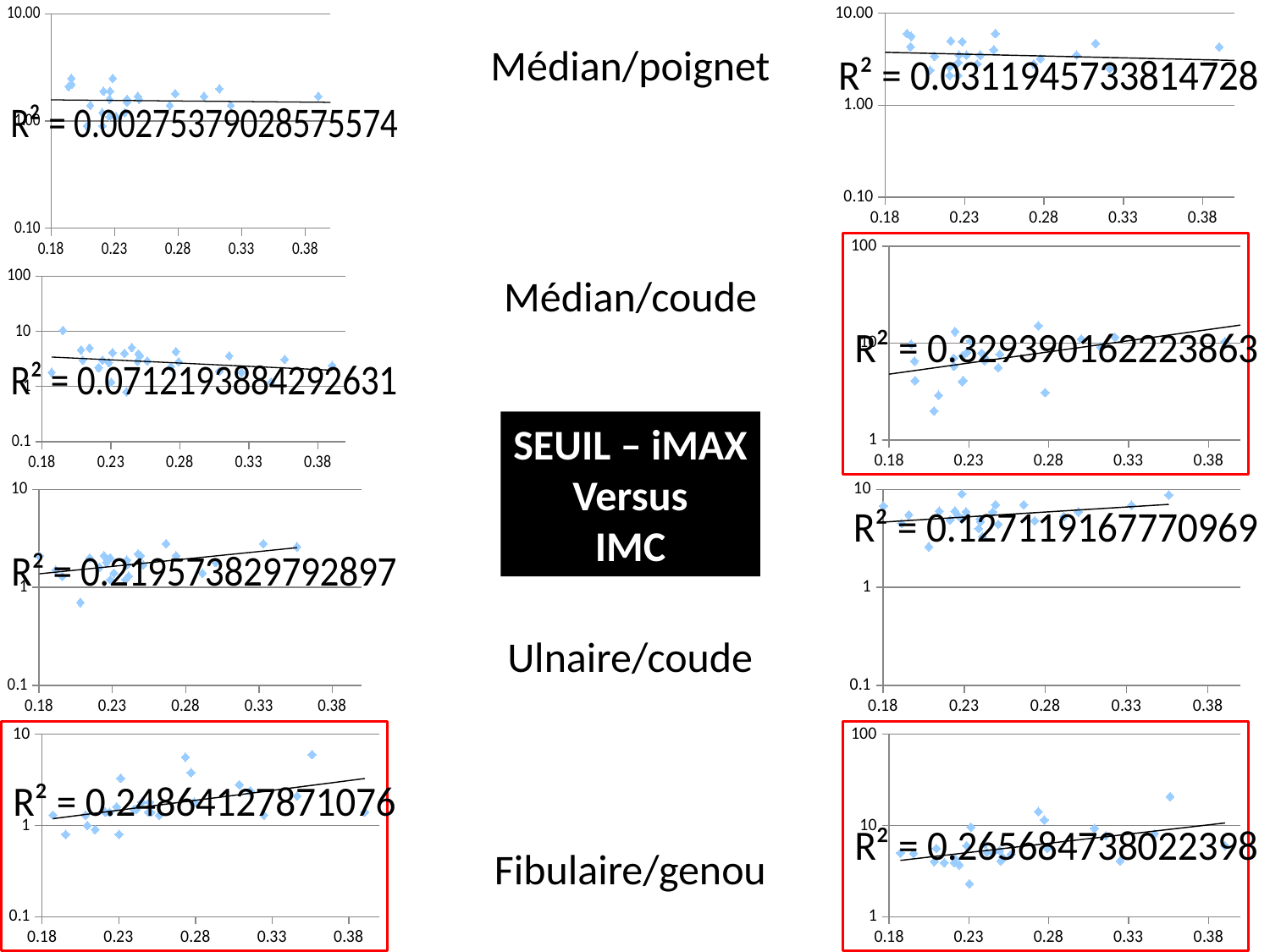
How many charts on the slide are outlined with a red box? 3 How many charts are shown on the slide? 8 For the chart in the second row on the left (Médian/coude row), what R² value is printed? 0.0712193884292631 For the top-right chart (Médian/poignet row), what R² value is printed? 0.0311945733814728 For the top-left chart (Médian/poignet row), what R² value is printed? 0.00275379028575574 What kind of chart is used throughout this slide? scatter chart For the bottom-right chart (Fibulaire/genou row), what R² value is printed? 0.265684738022398 Which chart on the slide shows the highest R² value? the second-row right chart (Médian/coude row), R² = 0.329390162223863 For the chart in the third row on the right (Ulnaire/coude row), what R² value is printed? 0.127119167770969 In the second-row left chart (Médian/coude row), does the trend line rise or fall as the x-axis increases? fall For the chart in the second row on the right (Médian/coude row), what R² value is printed? 0.329390162223863 Which has the larger R² value: the bottom-left chart or the bottom-right chart? the bottom-right chart